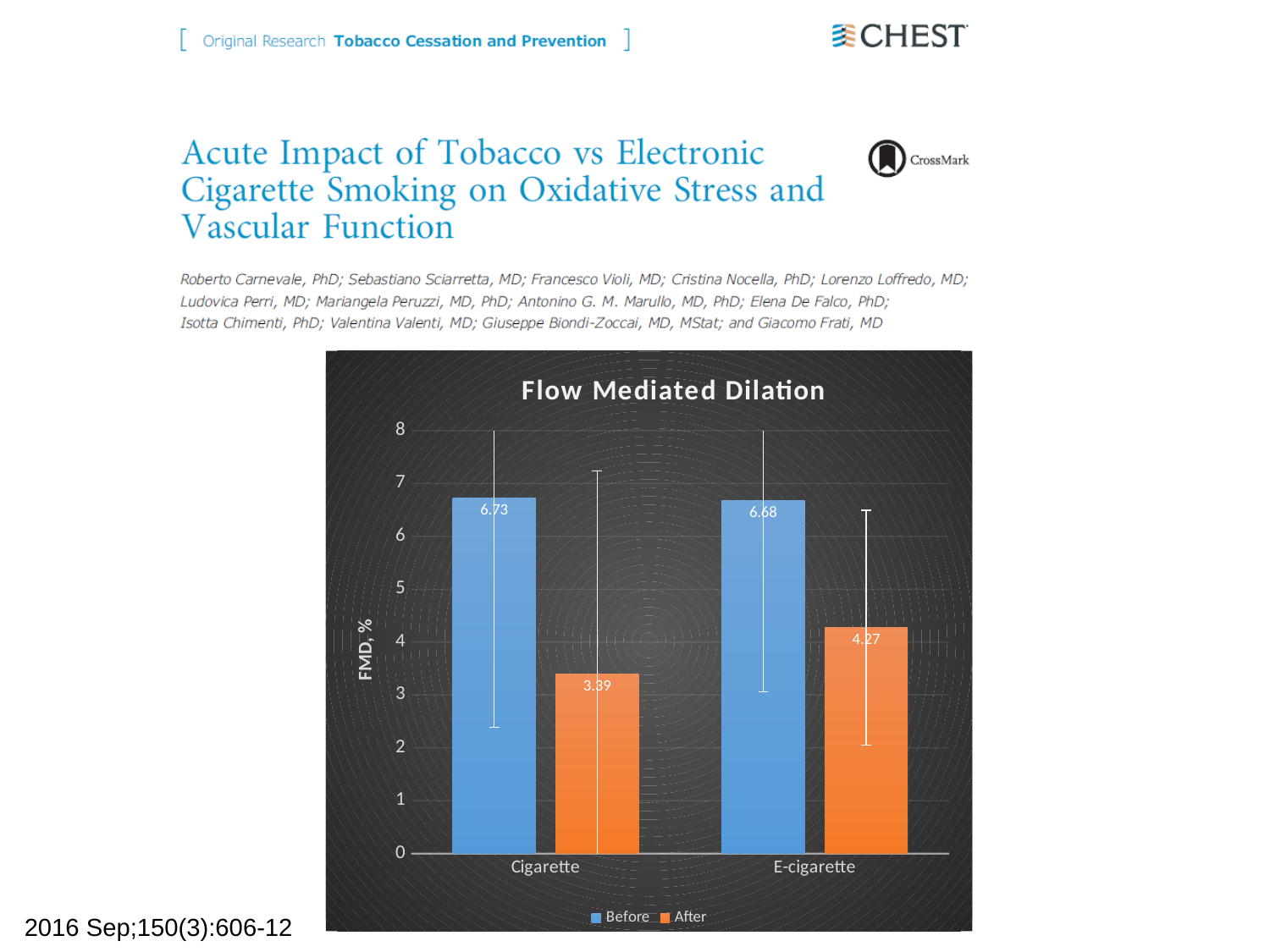
What kind of chart is shown on the slide? Bar chart What is the Before value for E-cigarette? 6.68 Which is larger, the After value for Cigarette or the After value for E-cigarette? E-cigarette What is the difference between the After values for E-cigarette and Cigarette? 0.88 How many categories are shown on the x axis? 2 What is the After value for E-cigarette in the Flow Mediated Dilation chart? 4.27 What is the difference between the Before and After values for Cigarette? 3.34 Which bar has the lowest value in the chart? Cigarette, After What is the Before value for Cigarette in the Flow Mediated Dilation chart? 6.73 What is the label of the y axis? FMD, % How many series does the legend list? 2 What is the After value for Cigarette? 3.39